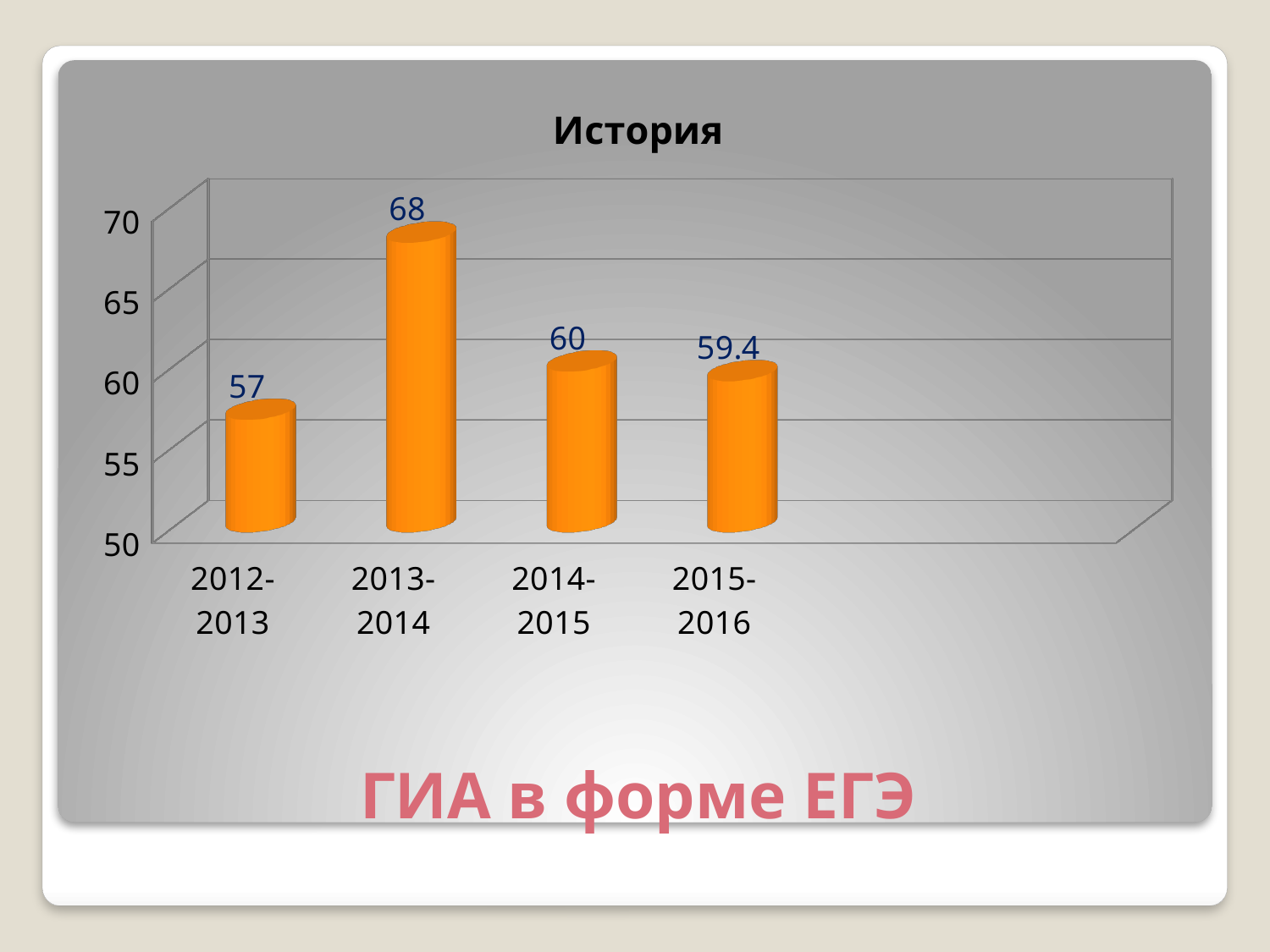
Which year has the lowest value? 2012-2013 What is the difference between the values for 2013-2014 and 2012-2013? 11 Is the value for 2013-2014 greater or less than 65? greater What kind of chart is shown on the slide? bar chart What is the value for 2012-2013? 57 What is the value for 2013-2014? 68 Which year has the highest value? 2013-2014 What is the title of the chart? История What is the difference between the values for 2014-2015 and 2015-2016? 0.6 How many categories are shown on the x axis? 4 Which is larger, the value for 2014-2015 or the value for 2012-2013? 2014-2015 What is the value for 2015-2016? 59.4